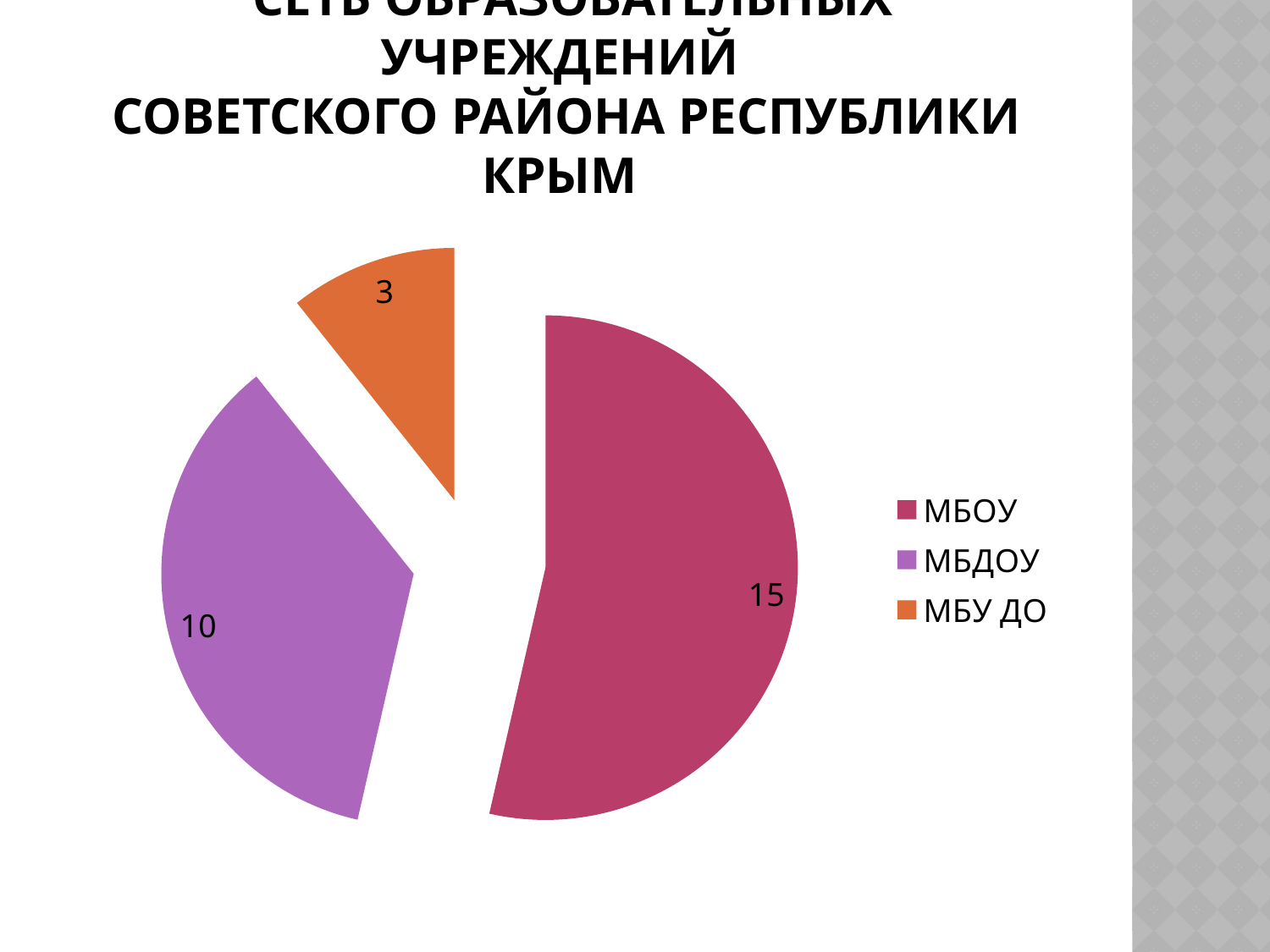
What is the difference between the values for МБОУ and МБДОУ? 5 What type of chart is shown on the slide? pie chart Which category has the smallest slice of the pie? МБУ ДО What is the value for МБУ ДО? 3 Which category has the largest slice of the pie? МБОУ What is the total of all slices in the pie chart? 28 What is the value for МБДОУ? 10 Which is larger, the value for МБДОУ or the value for МБУ ДО? МБДОУ How many categories does the pie chart show? 3 What is the difference between the values for МБДОУ and МБУ ДО? 7 What is the value for МБОУ? 15 What colour is the slice for МБУ ДО? orange